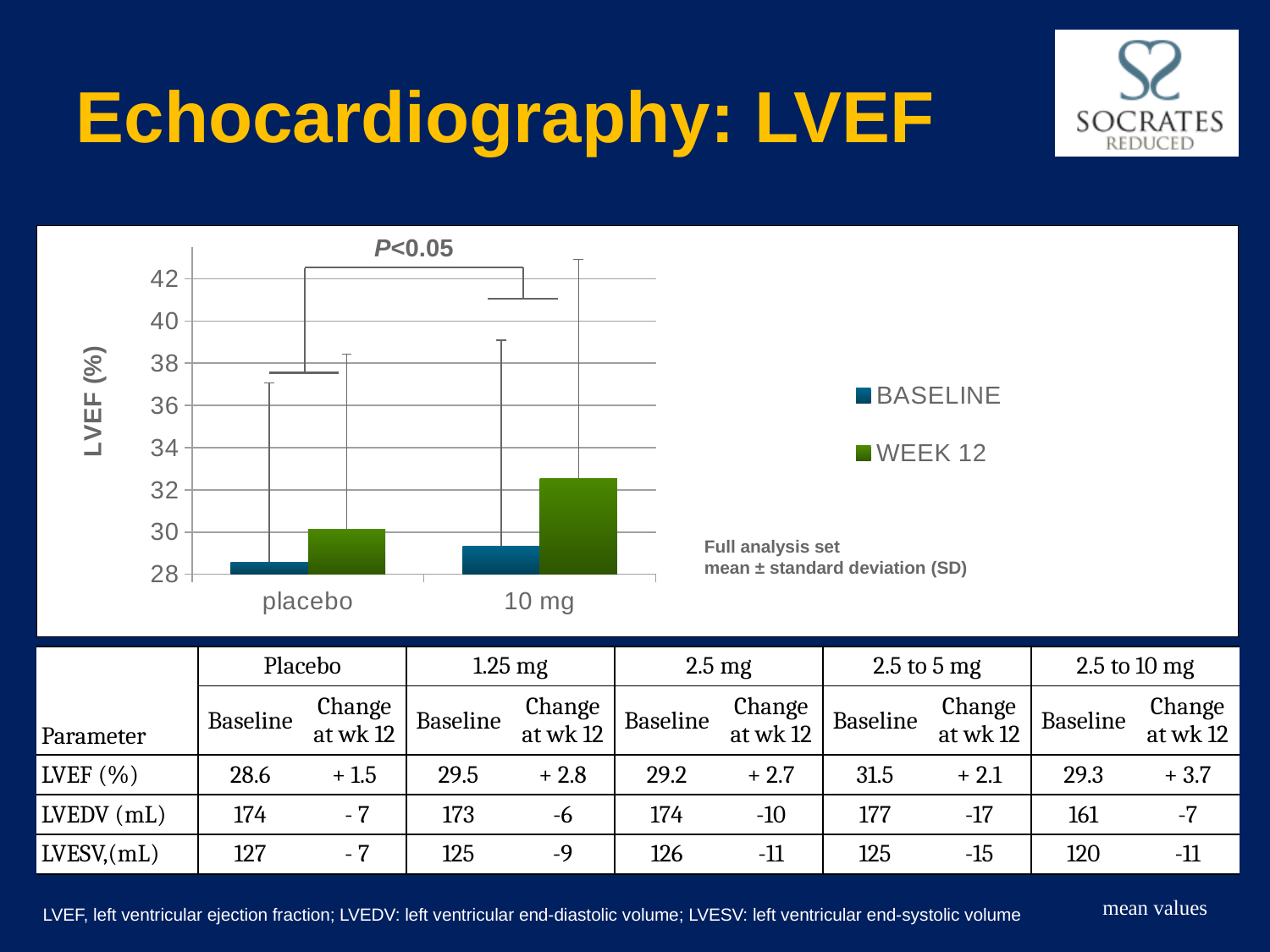
Is the BASELINE value for 10 mg greater or less than 30? less Which bar in the chart is the lowest overall? BASELINE for placebo How many categories are shown on the x axis of the chart? 2 Is the WEEK 12 value for placebo greater or less than 32? less Which has the larger WEEK 12 value in the chart, placebo or 10 mg? 10 mg What is the label on the y axis of the chart? LVEF (%) Is the WEEK 12 value for 10 mg greater or less than 30? greater Which category has the highest WEEK 12 bar in the chart? 10 mg Does the WEEK 12 series rise or fall from placebo to 10 mg? rise What kind of chart is shown on the slide? bar chart How many series does the chart legend list? 2